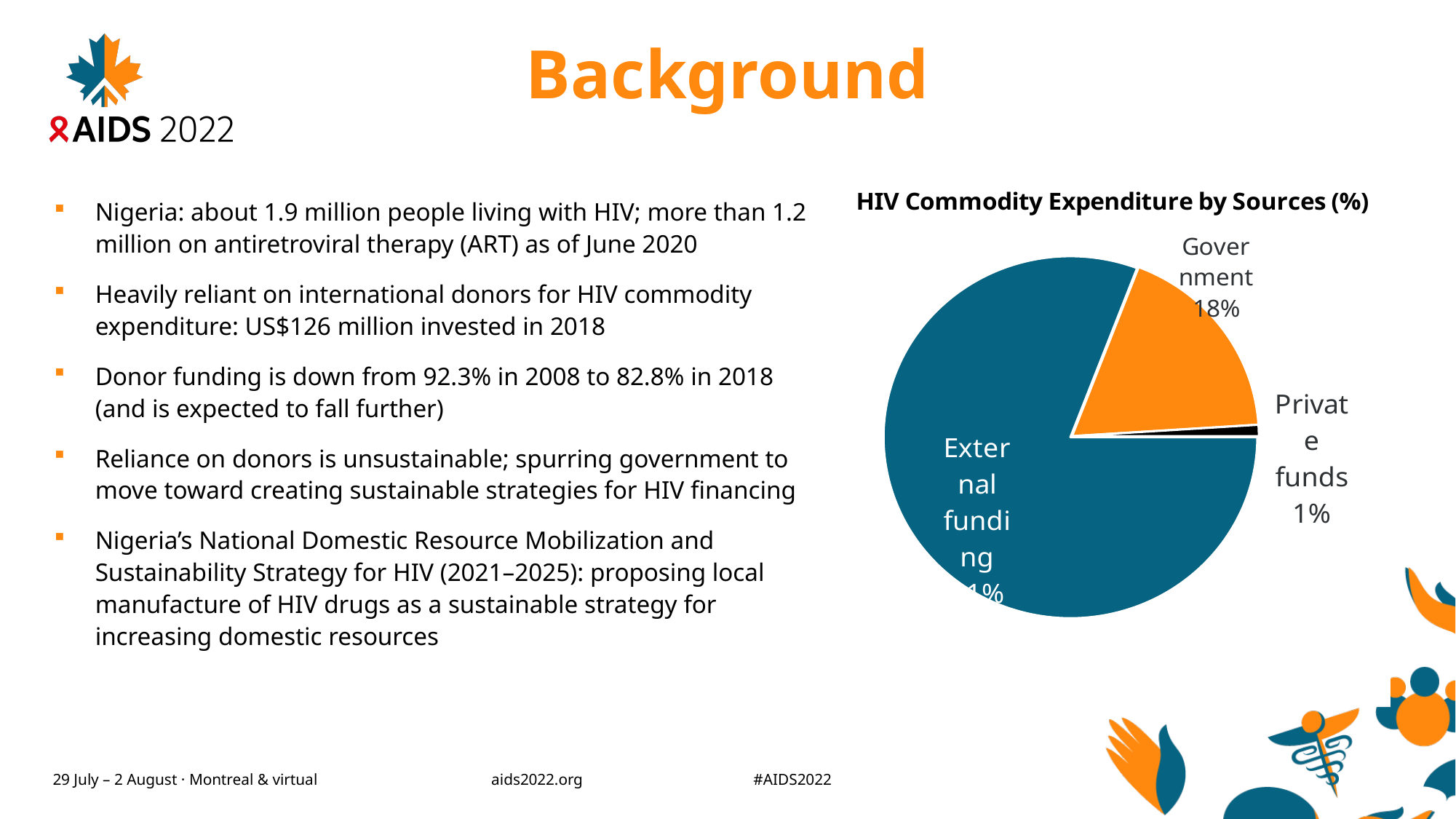
Which source accounts for the smallest share of HIV commodity expenditure? Private funds Which source accounts for the largest share of HIV commodity expenditure? External funding How many sources (slices) are shown in the pie chart? 3 What percentage of HIV commodity expenditure comes from Private funds? 1% How many percentage points larger is the Government share than the Private funds share? 17 Which is larger, the share from Government or the share from Private funds? Government What kind of chart is shown on the slide? pie chart What is the title of the chart? HIV Commodity Expenditure by Sources (%) What percentage of HIV commodity expenditure comes from Government? 18% What colour is the External funding slice? teal blue